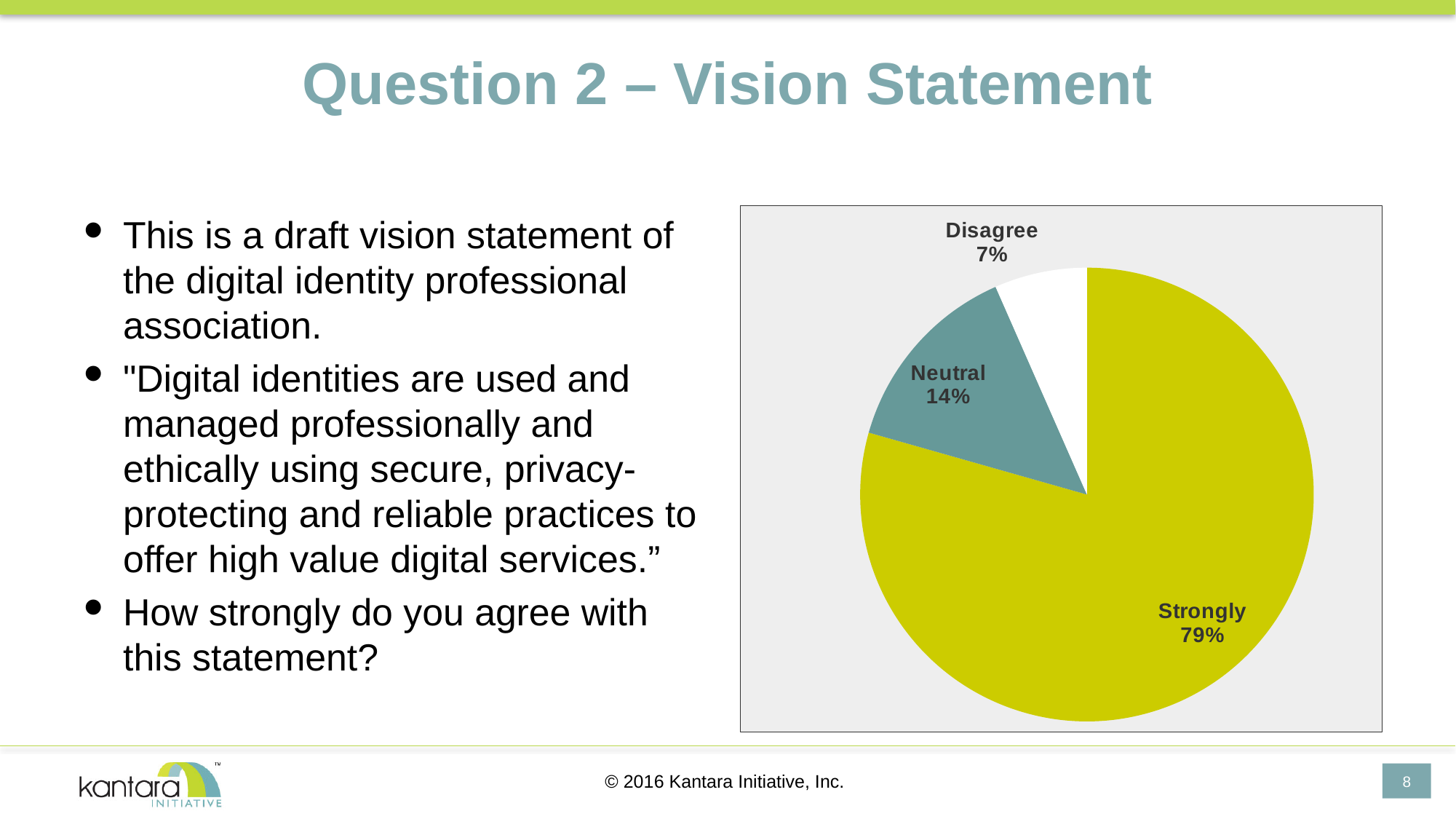
What colour is the Strongly slice of the pie? yellow-green Which is larger, the Neutral slice or the Disagree slice? Neutral How many slices does the pie chart have? 3 What percentage of the pie is labelled Strongly? 79% What percentage of the pie is labelled Neutral? 14% Which slice of the pie is the largest? Strongly Which slice of the pie is the smallest? Disagree What kind of chart is shown on the slide? pie chart What is the title of the slide containing the pie chart? Question 2 – Vision Statement What is the difference in percentage points between the Neutral slice and the Disagree slice? 7 What percentage of the pie is labelled Disagree? 7% What is the difference in percentage points between the Strongly slice and the Neutral slice? 65